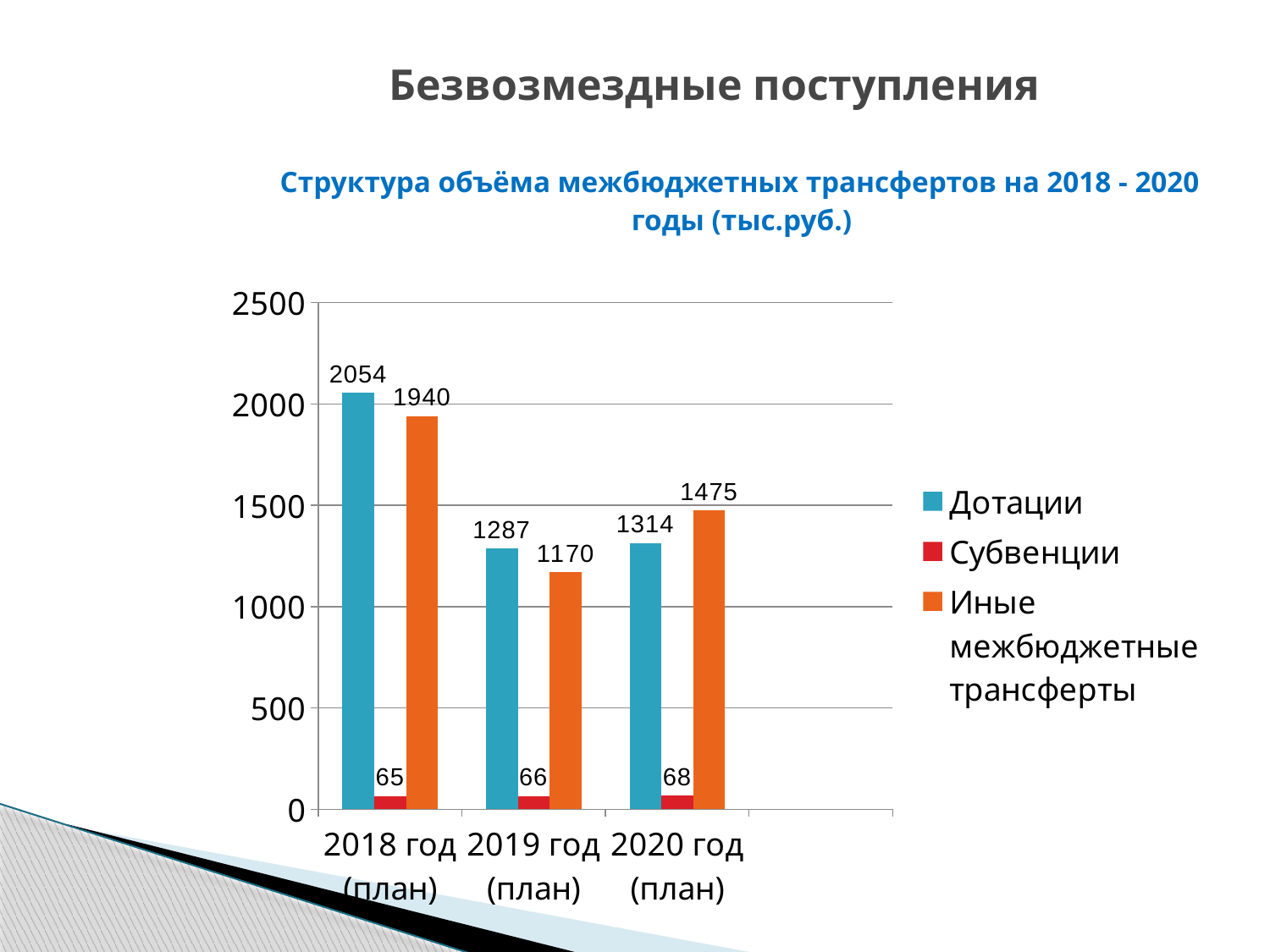
In which year is Иные межбюджетные трансферты the lowest? 2019 год (план) What is the value of Иные межбюджетные трансферты for 2020 год (план)? 1475 What is the value of Дотации for 2018 год (план)? 2054 What colour are the Субвенции bars? red What is the difference between Дотации and Иные межбюджетные трансферты in 2019 год (план)? 117 What is the value of Субвенции for 2019 год (план)? 66 How many year categories are shown on the x axis? 3 Which is larger in 2020 год (план): Дотации or Иные межбюджетные трансферты? Иные межбюджетные трансферты What kind of chart is shown on the slide? bar chart In which year is Дотации the highest? 2018 год (план) Is the value of Дотации for 2019 год (план) greater or less than 1500? less How many series does the legend list? 3